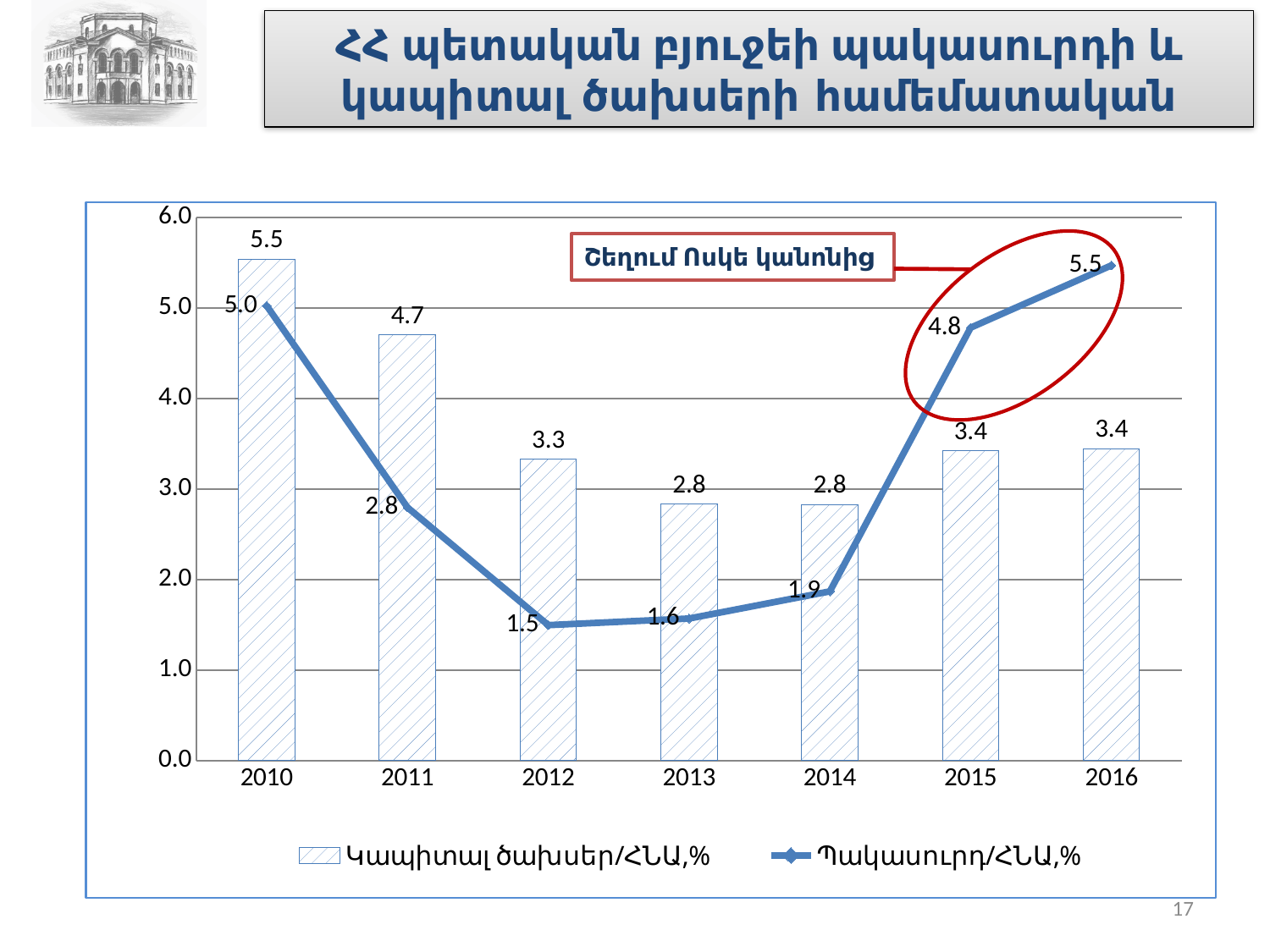
What is the difference between Պակասուրդ/ՀՆԱ,% in 2016 and in 2015? 0.7 How many years are shown on the x axis? 7 What is the value of Պակասուրդ/ՀՆԱ,% for 2012? 1.5 What is the value of Կապիտալ ծախսեր/ՀՆԱ,% for 2011? 4.7 Is the value of Կապիտալ ծախսեր/ՀՆԱ,% for 2012 greater or less than 3.0? greater What kind of chart is shown on the slide? Combined bar and line chart Which is larger in 2014: Կապիտալ ծախսեր/ՀՆԱ,% or Պակասուրդ/ՀՆԱ,%? Կապիտալ ծախսեր/ՀՆԱ,% What is the value of Պակասուրդ/ՀՆԱ,% for 2015? 4.8 In which year is Պակասուրդ/ՀՆԱ,% lowest? 2012 Does Կապիտալ ծախսեր/ՀՆԱ,% rise or fall from 2010 to 2013? fall In which year is Կապիտալ ծախսեր/ՀՆԱ,% highest? 2010 How many series does the legend list? 2